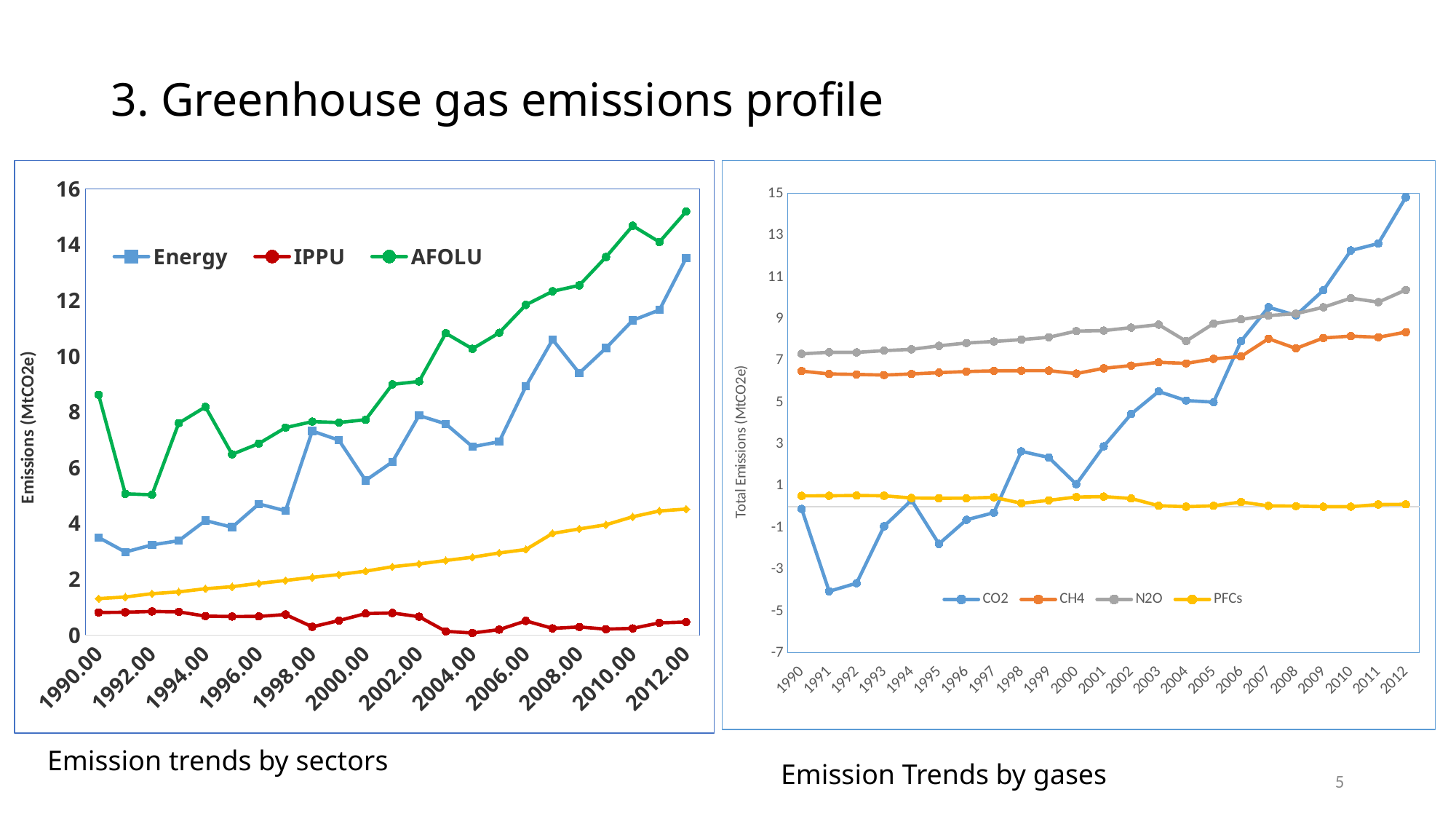
How many series does the legend list in the 'Emission Trends by gases' chart? 4 How many series does the legend list in the 'Emission trends by sectors' chart? 3 In the 'Emission Trends by gases' chart, which is larger in 2012, CO2 or CH4? CO2 What type of chart is the 'Emission trends by sectors' chart on the left? Line chart In the 'Emission Trends by gases' chart, is the CO2 value for 1991 greater or less than -3? less In the 'Emission trends by sectors' chart, is the AFOLU value for 1990 greater or less than 8? greater In the 'Emission trends by sectors' chart, which series has the highest value in 2012? AFOLU In the 'Emission trends by sectors' chart, which of the three legend series has the lowest values across all years? IPPU In the 'Emission trends by sectors' chart, is the Energy value for 2012 greater or less than 12? greater In the 'Emission Trends by gases' chart, which gas has the lowest value in 1991? CO2 In the 'Emission Trends by gases' chart, how many years are shown on the x axis? 23 In the 'Emission Trends by gases' chart, does the CO2 series overall rise or fall from 1990 to 2012? Rise